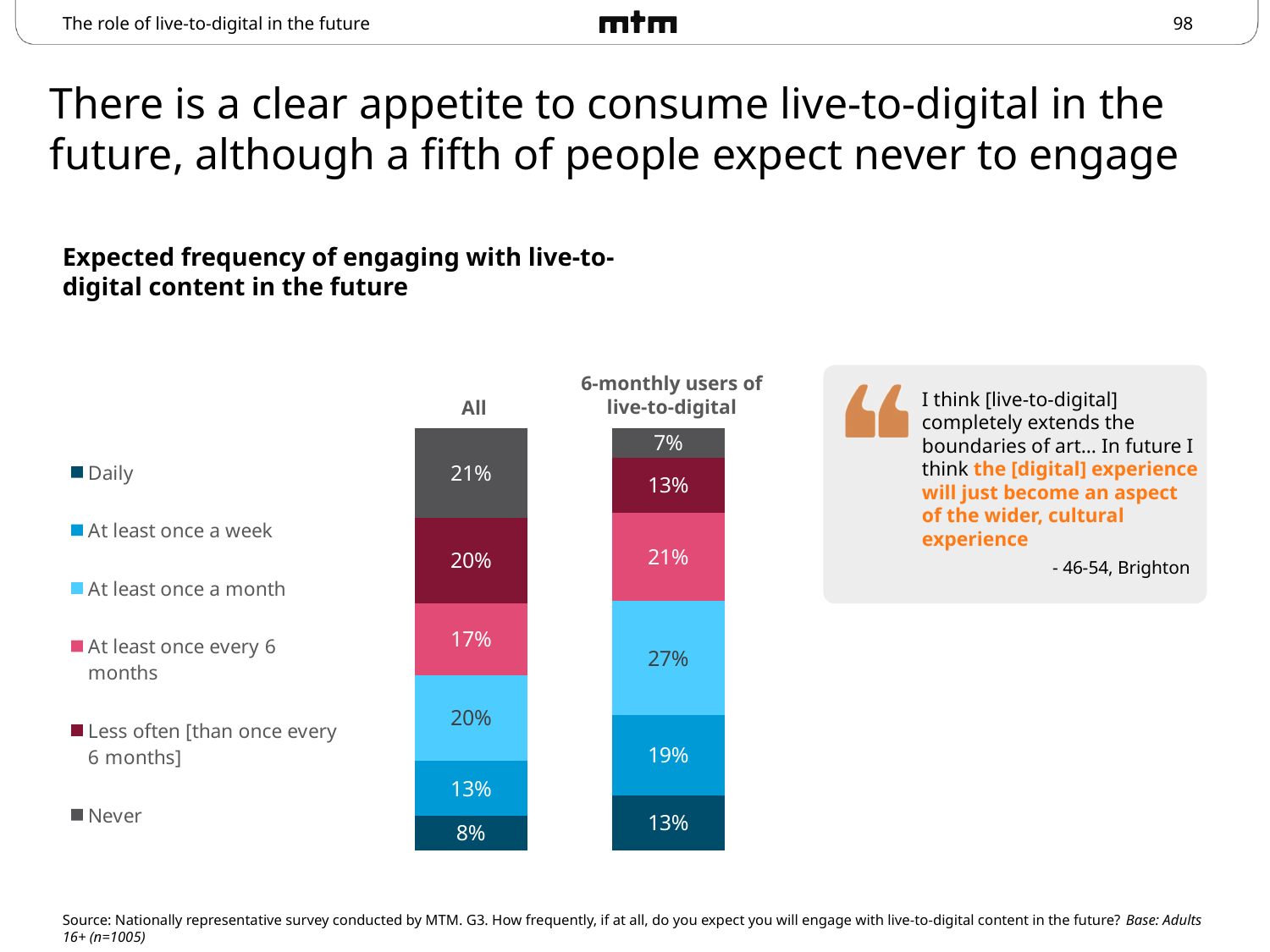
What percentage of the 'All' group expect to engage daily? 8% What percentage of 6-monthly users of live-to-digital expect to never engage? 7% What is the difference between the 'Never' share for 'All' and for '6-monthly users of live-to-digital'? 14 percentage points Which segment is the smallest in the 'All' bar? Daily How many bars (categories) are plotted in the chart? 2 Which group has a larger share expecting to engage at least once a week: 'All' or '6-monthly users of live-to-digital'? 6-monthly users of live-to-digital How many series does the legend list? 6 What kind of chart is shown on the slide? Stacked bar chart What is the title of the chart? Expected frequency of engaging with live-to-digital content in the future What percentage of 6-monthly users of live-to-digital expect to engage at least once a month? 27% Which segment is the largest in the '6-monthly users of live-to-digital' bar? At least once a month What percentage of the 'All' group expect to never engage with live-to-digital content? 21%